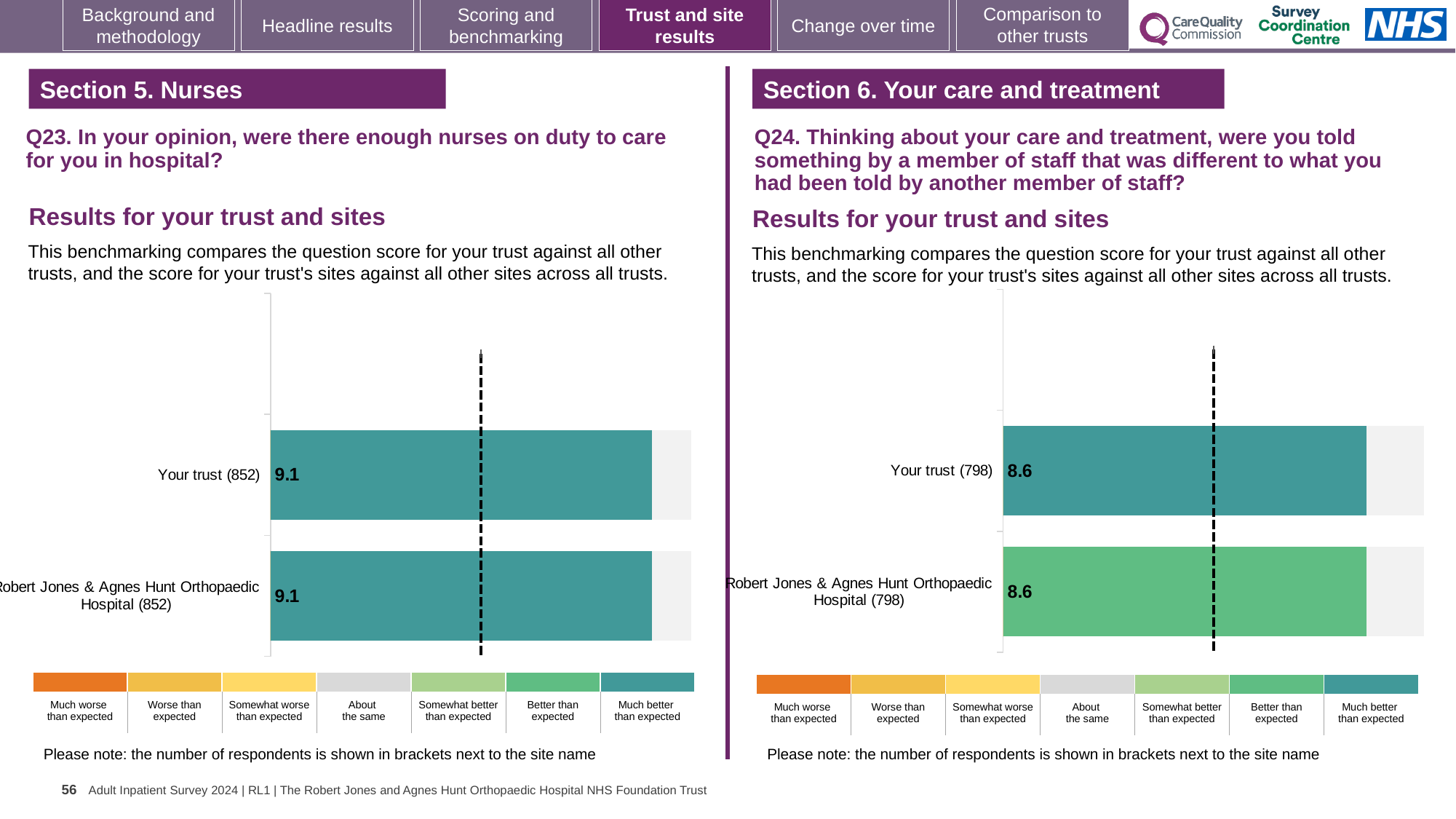
On the Q24 chart (right), what is the score for Your trust? 8.6 On the Q24 chart (right), what is the score for Robert Jones & Agnes Hunt Orthopaedic Hospital? 8.6 Is the score for Your trust on the Q24 chart (right) larger or smaller than the score for Your trust on the Q23 chart (left)? Smaller On the Q23 chart (left), what is the difference between the score for Your trust and the score for Robert Jones & Agnes Hunt Orthopaedic Hospital? 0 How many bars are plotted on the Q23 chart (left)? 2 On the Q23 chart (left), what is the score for Robert Jones & Agnes Hunt Orthopaedic Hospital? 9.1 What kind of chart is used for the Q23 results on the left? Bar chart On the Q24 chart (right), what is the difference between the score for Your trust and the score for Robert Jones & Agnes Hunt Orthopaedic Hospital? 0 On the Q23 chart (left), what is the score for Your trust? 9.1 On the Q24 chart (right), how many respondents are shown in brackets for Robert Jones & Agnes Hunt Orthopaedic Hospital? 798 How many bars are plotted on the Q24 chart (right)? 2 On the Q23 chart (left), how many respondents are shown in brackets for Your trust? 852